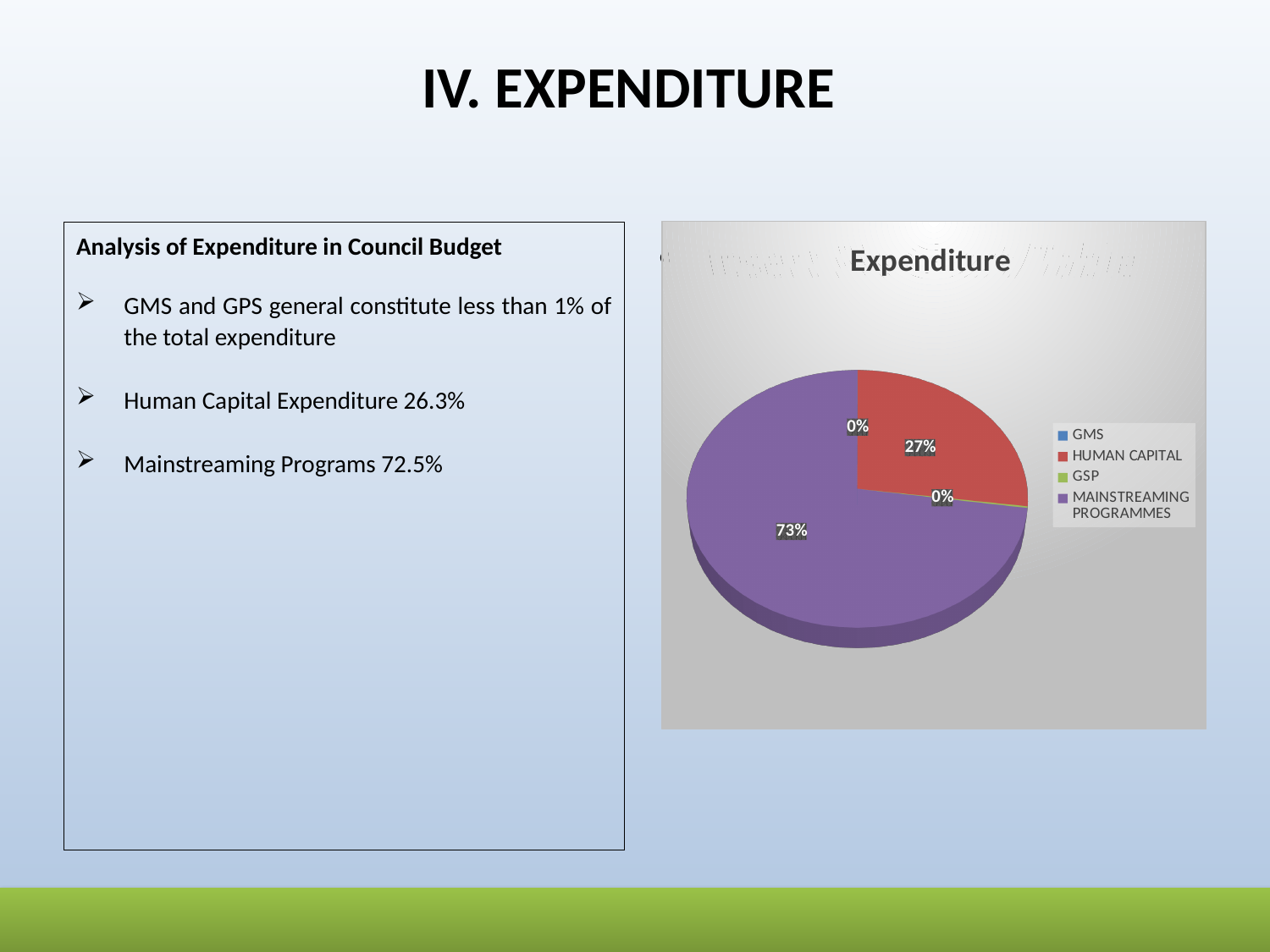
What value is shown for GSP in the pie chart? 0% Which is larger, the slice for HUMAN CAPITAL or the slice for MAINSTREAMING PROGRAMMES? MAINSTREAMING PROGRAMMES Which category has the largest slice of the pie? MAINSTREAMING PROGRAMMES What colour is the MAINSTREAMING PROGRAMMES slice in the pie chart? Purple What value is shown for GMS in the pie chart? 0% What is the title of the chart? Expenditure What type of chart is shown on the slide? Pie chart What is the difference in percentage points between MAINSTREAMING PROGRAMMES and HUMAN CAPITAL? 46% What percentage of the pie does HUMAN CAPITAL represent? 27% What percentage of the pie does MAINSTREAMING PROGRAMMES represent? 73% How many categories does the legend of the pie chart list? 4